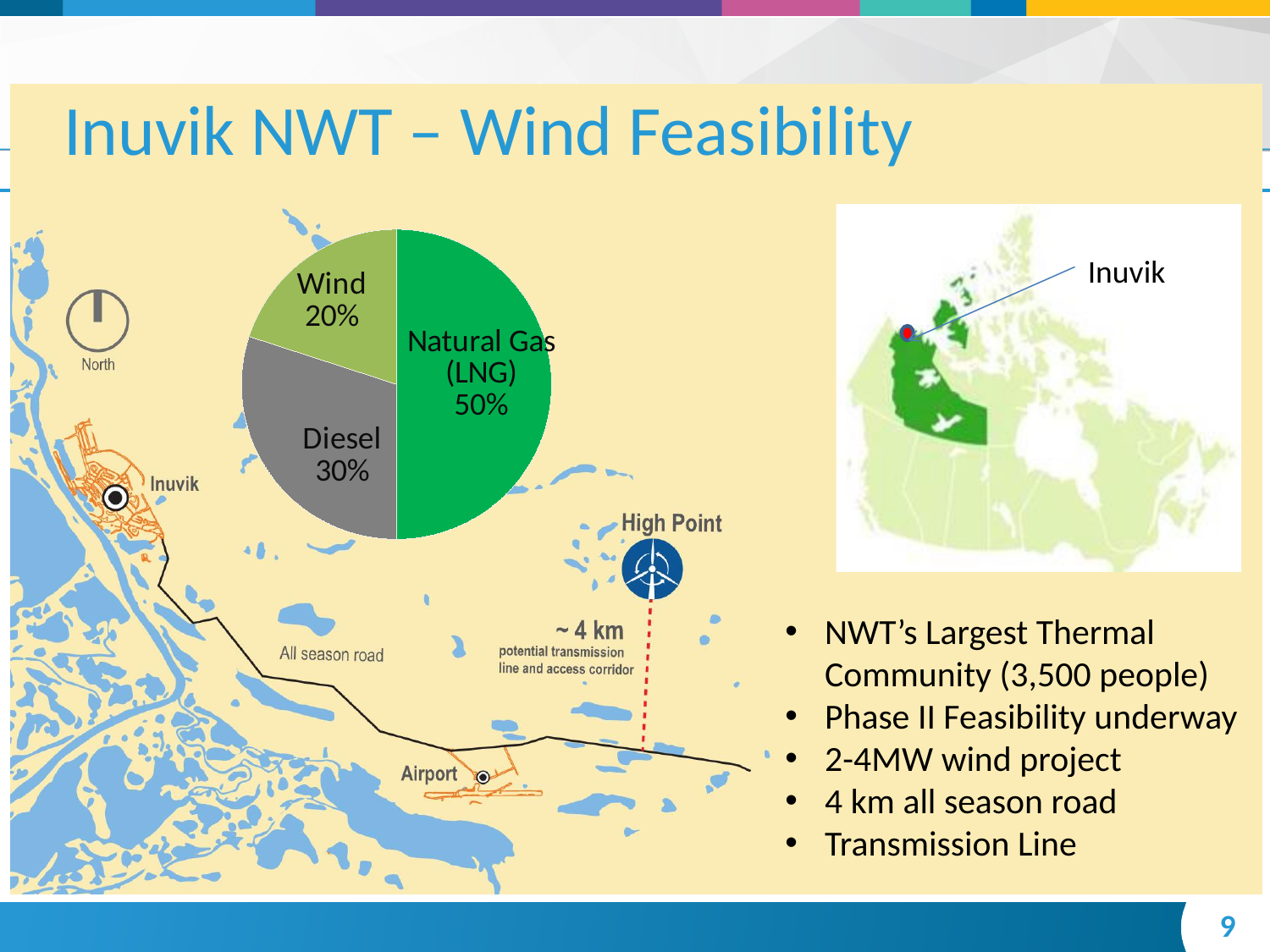
What share of the pie chart is Natural Gas (LNG)? 50% What share of the pie chart is Diesel? 30% What colour is the Diesel slice of the pie chart? Grey How many slices does the pie chart have? 3 Which slice of the pie chart is the smallest? Wind Which is larger in the pie chart, Diesel or Wind? Diesel What share of the pie chart is Wind? 20% What kind of chart is shown on the slide? Pie chart What is the combined share of Diesel and Wind in the pie chart? 50% What is the difference in percentage points between the Natural Gas (LNG) and Diesel slices? 20 What is the difference in percentage points between the Diesel and Wind slices? 10 Which slice of the pie chart is the largest? Natural Gas (LNG)